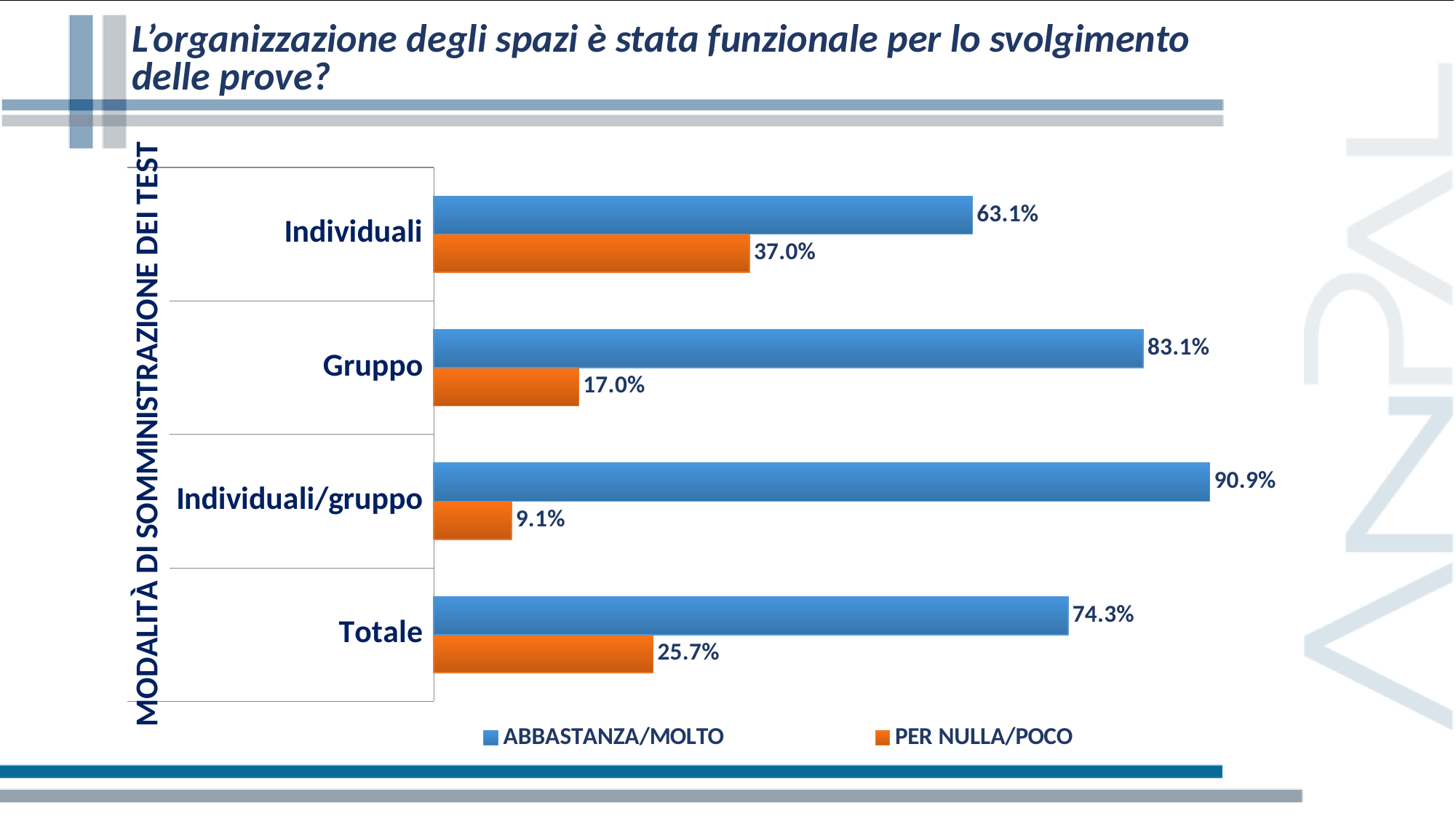
What is the ABBASTANZA/MOLTO value for Totale? 74.3% What is the PER NULLA/POCO value for Individuali? 37.0% What kind of chart is shown on the slide? Bar chart Which category has the highest ABBASTANZA/MOLTO value? Individuali/gruppo How many categories are shown on the chart? 4 What is the PER NULLA/POCO value for Individuali/gruppo? 9.1% How many series does the legend list? 2 What is the ABBASTANZA/MOLTO value for Gruppo? 83.1% What is the label of the vertical axis? MODALITÀ DI SOMMINISTRAZIONE DEI TEST What is the difference between the ABBASTANZA/MOLTO and PER NULLA/POCO values for Gruppo? 66.1% Which category has the lowest PER NULLA/POCO value? Individuali/gruppo Which is larger: the PER NULLA/POCO value for Individuali or for Totale? Individuali